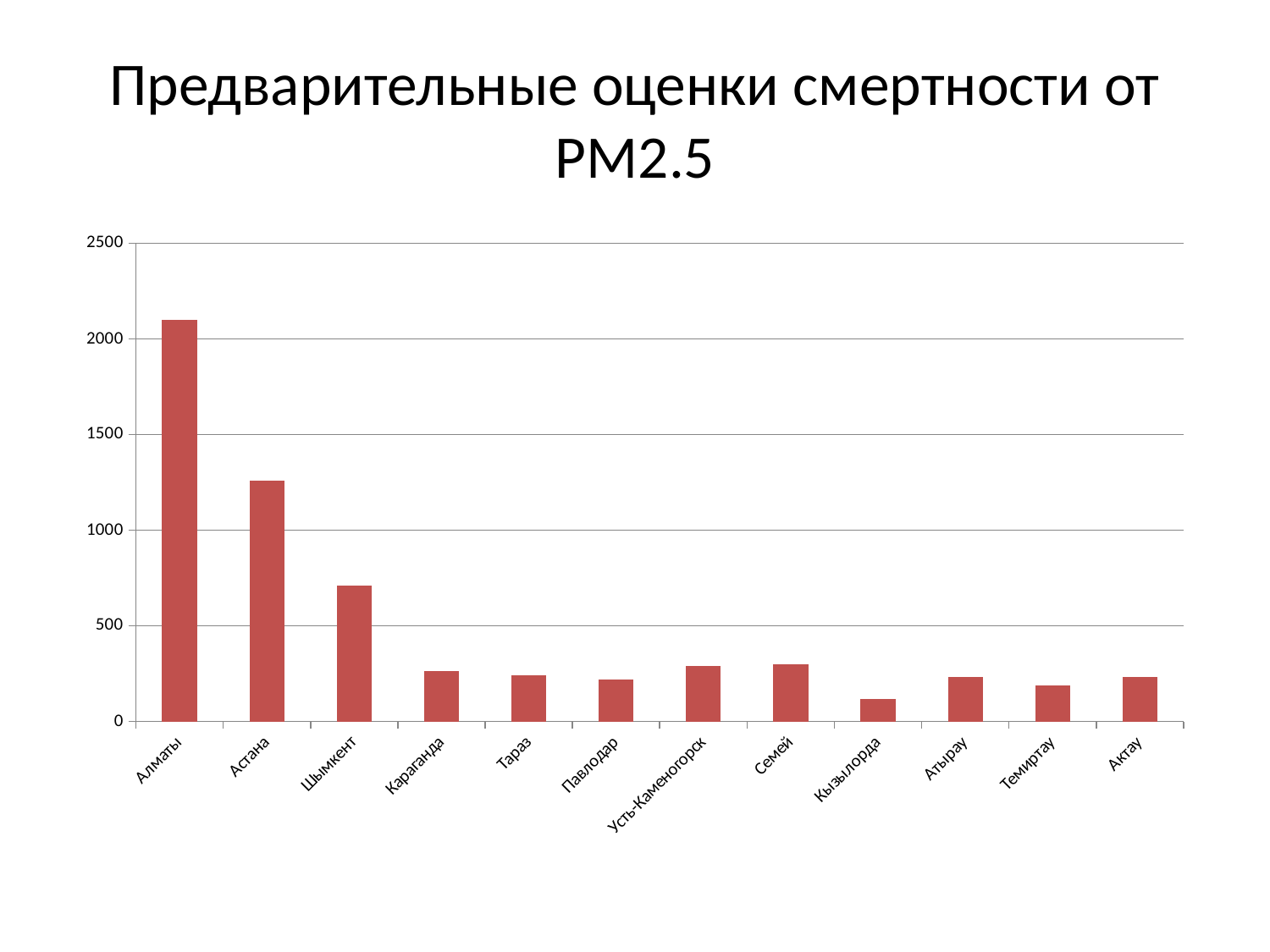
Is the value for Шымкент greater or less than 500? greater Is the value for Астана greater or less than 1000? greater Which has a larger value, Шымкент or Караганда? Шымкент Is the value for Алматы greater or less than 2000? greater What is the title of the chart on the slide? Предварительные оценки смертности от PM2.5 Which has a larger value, Астана or Шымкент? Астана Which city has the highest value in the chart? Алматы How many cities are shown on the x axis of the chart? 12 Which city has the lowest value in the chart? Кызылорда What kind of chart is shown on the slide? bar chart